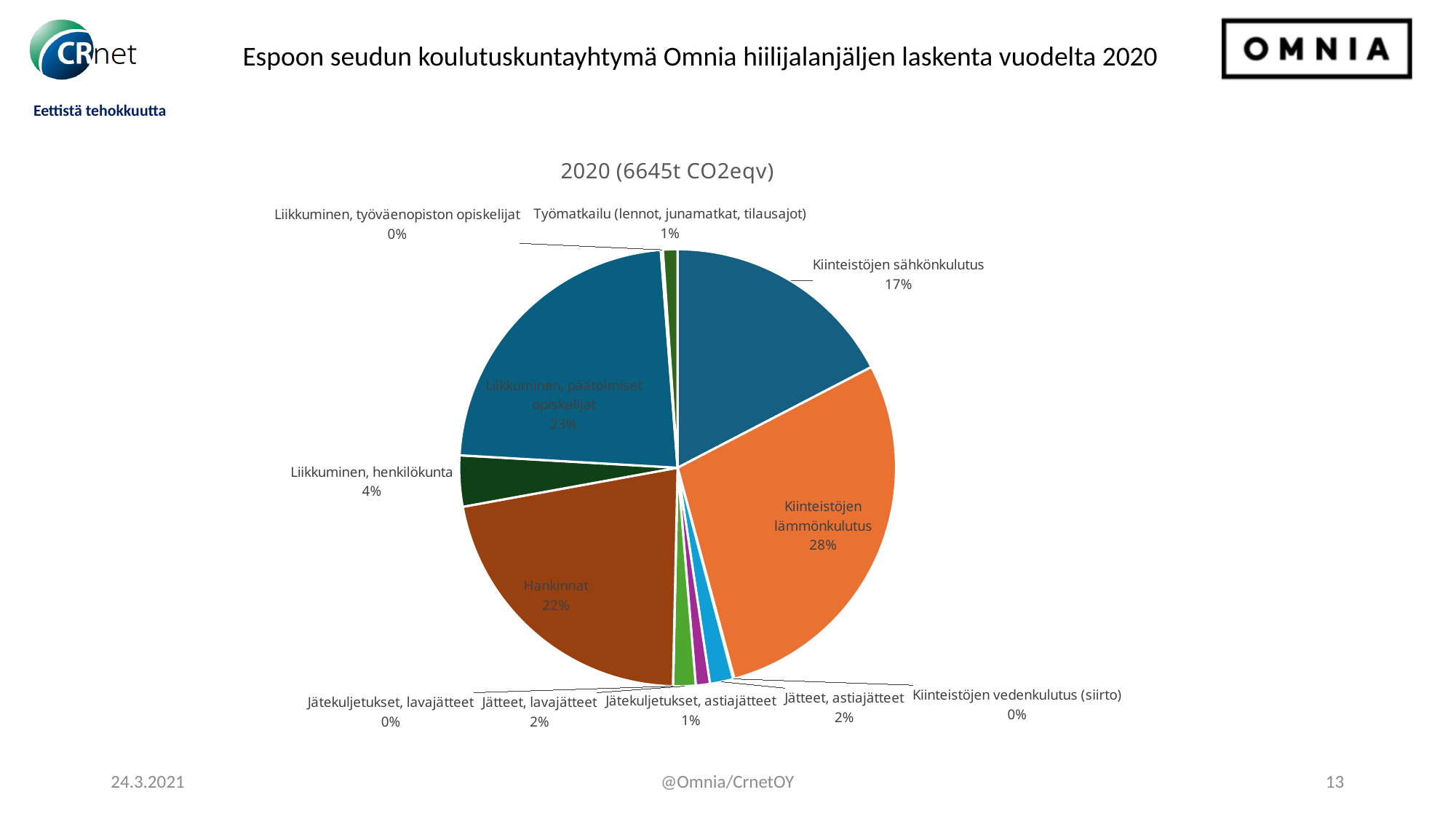
What share of the pie is Kiinteistöjen lämmönkulutus? 28% What percentage is shown for Kiinteistöjen sähkönkulutus? 17% What is the title of the chart? 2020 (6645t CO2eqv) What percentage is shown for Työmatkailu (lennot, junamatkat, tilausajot)? 1% How many categories are shown in the pie chart? 12 What share of the pie is Hankinnat? 22% What percentage is shown for Liikkuminen, henkilökunta? 4% Which category has the largest share of the pie? Kiinteistöjen lämmönkulutus Which is larger, Hankinnat or Kiinteistöjen sähkönkulutus? Hankinnat What is the difference in percentage points between Kiinteistöjen lämmönkulutus and Kiinteistöjen sähkönkulutus? 11 What percentage is shown for Liikkuminen, päätoimiset opiskelijat? 23% What kind of chart is shown on the slide? pie chart